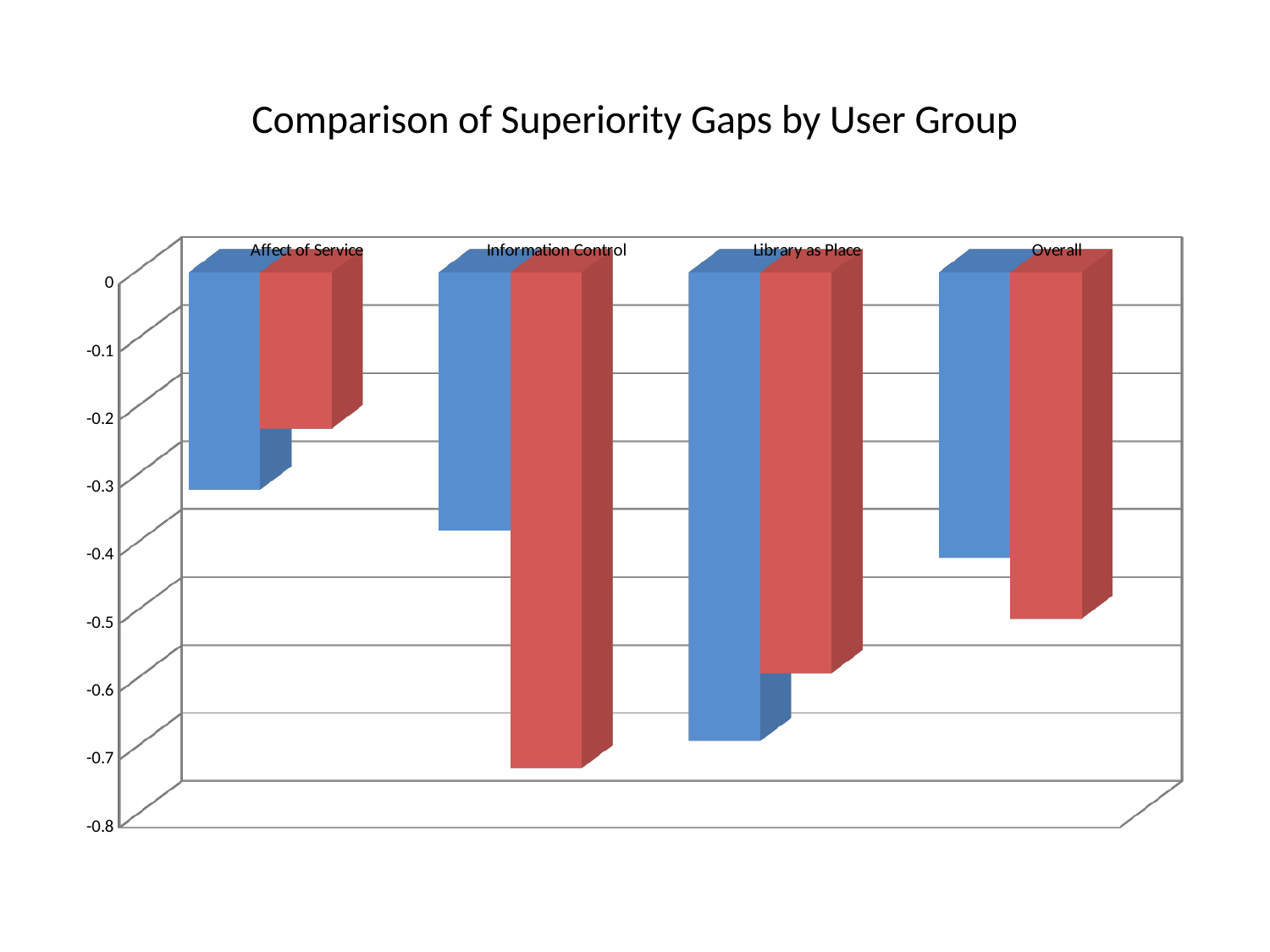
For Library as Place, which bar is more negative, the blue bar or the red bar? the blue bar Is the value of the red bar for Information Control greater or less than -0.6? less How many categories are shown on the x axis of the chart? 4 For Information Control, which bar is more negative, the blue bar or the red bar? the red bar Among the red bars, which category has the value closest to zero? Affect of Service Is the value of the blue bar for Library as Place greater or less than -0.6? less What is the title of the chart? Comparison of Superiority Gaps by User Group Is the value of the blue bar for Information Control greater or less than -0.5? greater Among the blue bars, which category has the most negative value? Library as Place What kind of chart is shown on the slide? bar chart How many bars are plotted for each category in the chart? 2